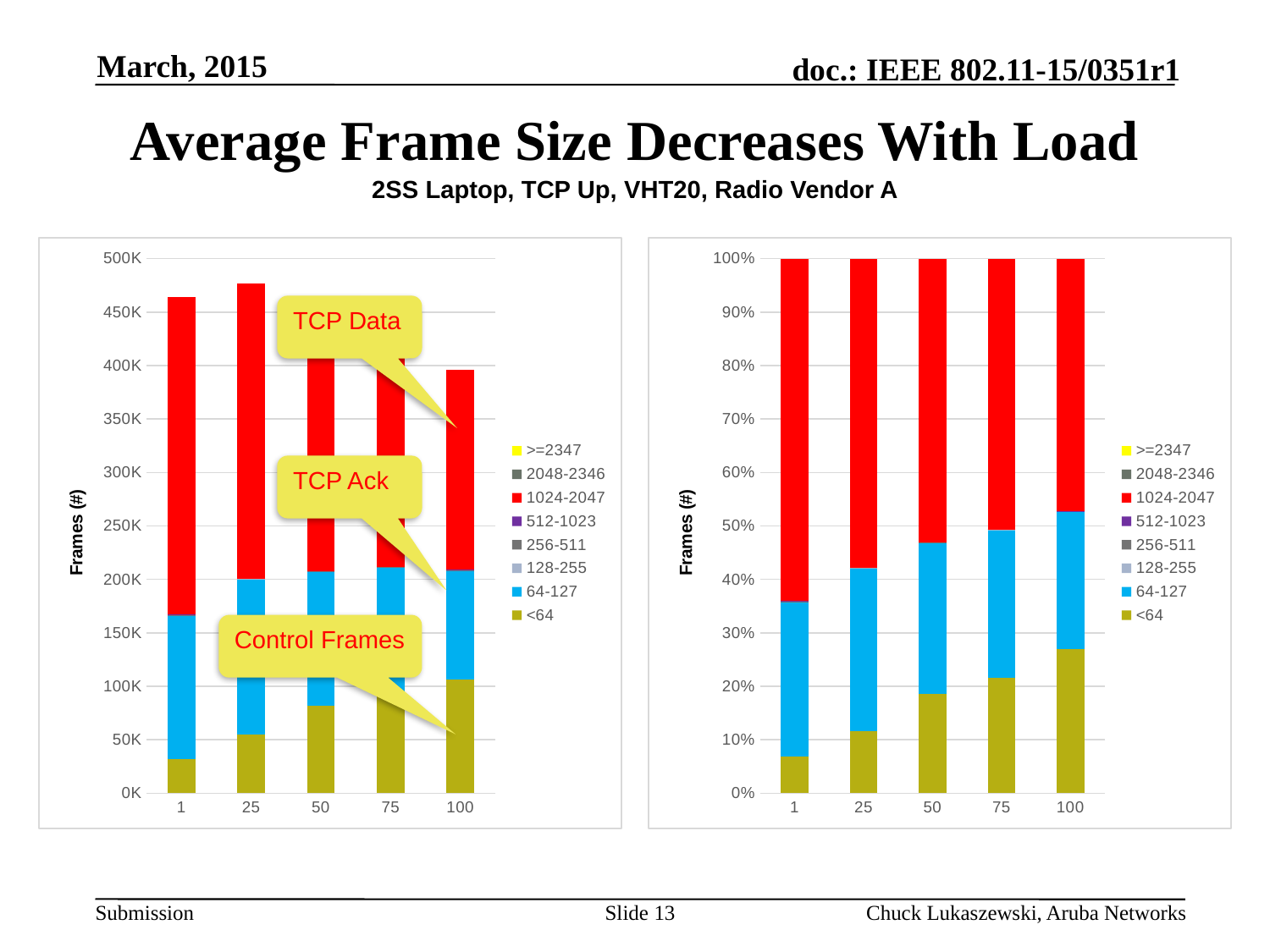
On the right chart, does the share of <64 frames rise or fall as the x-axis value increases from 1 to 100? rise On the left chart, is the total for category 100 greater or less than 450K? less On the left chart, is the total for category 1 greater or less than 450K? greater On the left chart, how many categories are shown on the x axis? 5 On the left chart, is the <64 segment for category 1 greater or less than 50K? less What kind of chart is the left chart? stacked bar chart On the right chart, how many series does the legend list? 8 On the left chart, which category has the shortest total bar? 100 On the left chart, which is larger: the <64 segment for category 100 or the <64 segment for category 1? 100 On the left chart, which category has the tallest total bar? 25